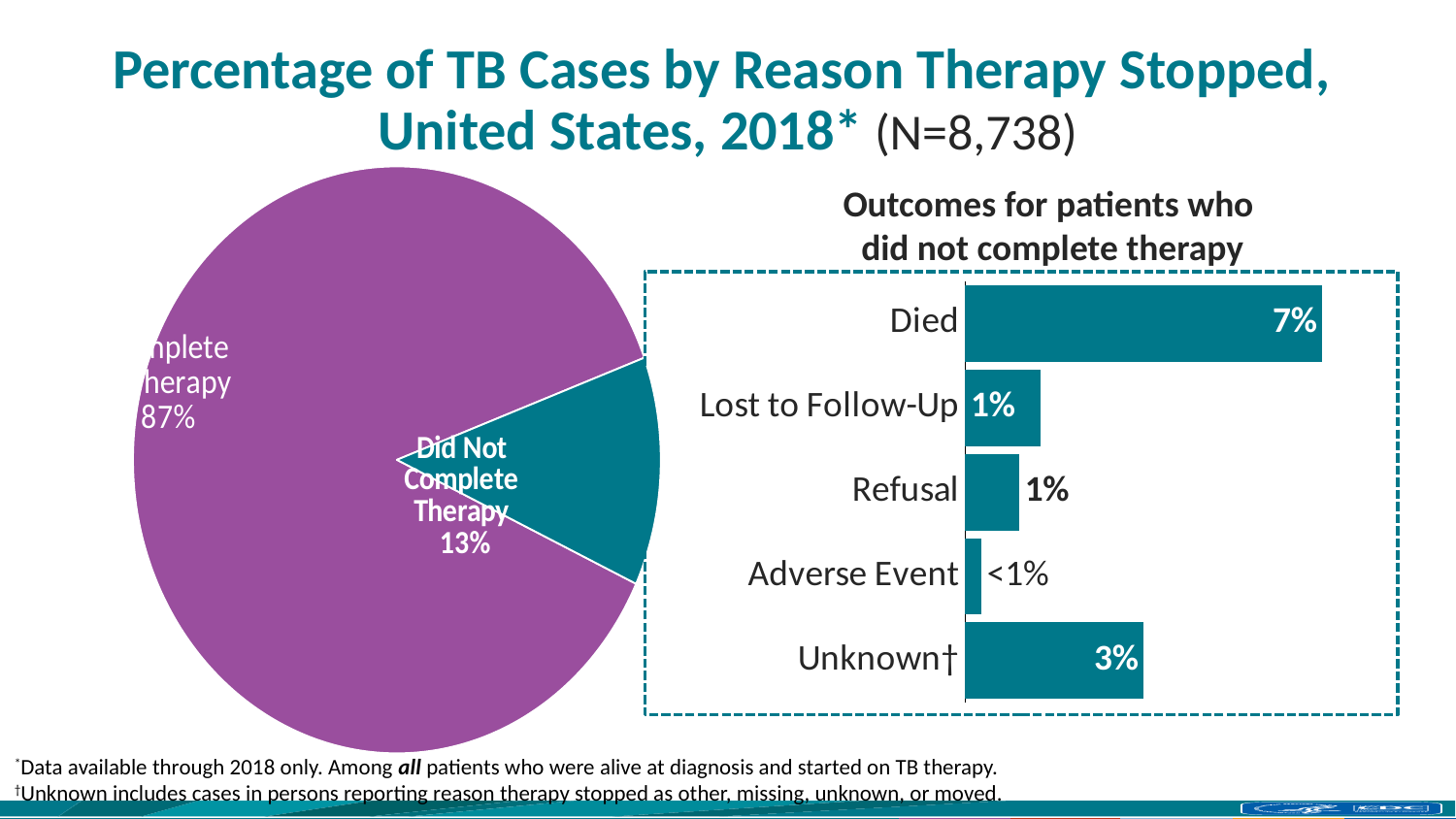
In the bar chart 'Outcomes for patients who did not complete therapy', how many categories are shown? 5 In the bar chart 'Outcomes for patients who did not complete therapy', which category has the highest value? Died In the bar chart 'Outcomes for patients who did not complete therapy', which is larger, Died or Unknown†? Died In the pie chart on the left, what percentage is shown for the large purple slice? 87% In the bar chart 'Outcomes for patients who did not complete therapy', what is the value for Unknown†? 3% What kind of chart is the 'Outcomes for patients who did not complete therapy' chart on the right? Bar chart In the bar chart 'Outcomes for patients who did not complete therapy', what is the difference between the values for Died and Unknown†? 4% In the bar chart 'Outcomes for patients who did not complete therapy', what is the value for Died? 7% What kind of chart is shown on the left side of the slide? Pie chart In the bar chart 'Outcomes for patients who did not complete therapy', which category has the lowest value? Adverse Event In the pie chart on the left, what share of TB cases is labelled 'Did Not Complete Therapy'? 13% In the bar chart 'Outcomes for patients who did not complete therapy', what is the value for Adverse Event? <1%